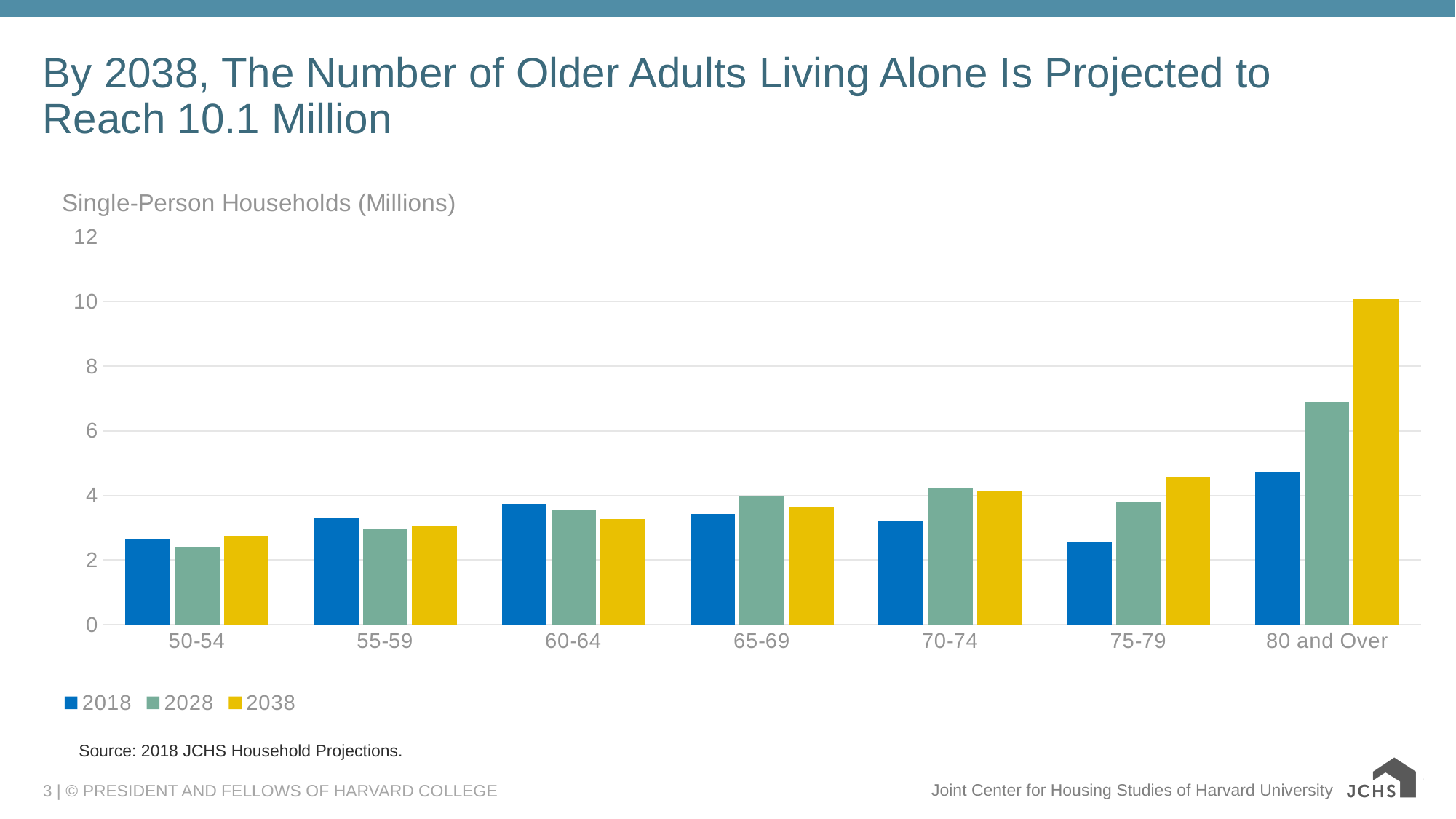
For the 60-64 age group, which is larger: the 2018 value or the 2038 value? 2018 Do the 2038 values rise or fall as the age groups move from 50-54 to 80 and Over? rise How many series does the legend list? 3 Which age group has the highest value for 2038? 80 and Over For the 65-69 age group, which is larger: the 2018 value or the 2028 value? 2028 Which age group has the lowest value for 2038? 50-54 How many age groups are shown on the x axis? 7 Is the 2038 value for 80 and Over greater or less than 8? greater Is the 2018 value for 60-64 greater or less than 4? less What kind of chart is shown on the slide? bar chart Which age group has the lowest value for 2028? 50-54 Is the 2028 value for 80 and Over greater or less than 6? greater